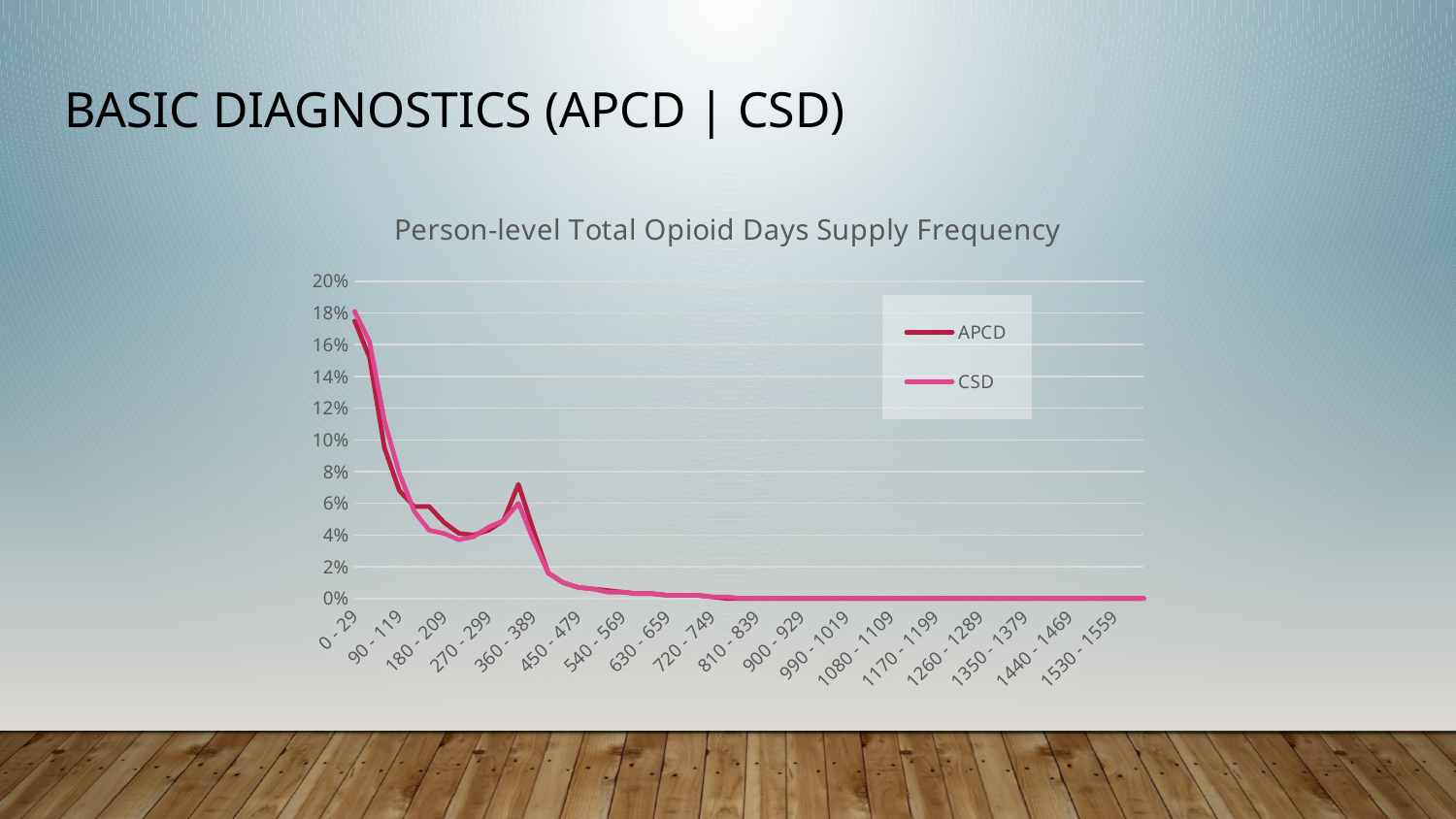
Do the values generally rise or fall moving from left to right along the x axis? fall Is the APCD value for the 540 - 569 category greater or less than 2%? less Is the APCD value for the 360 - 389 category greater or less than 8%? less At the 360 - 389 category, which series has the larger value, APCD or CSD? APCD For which category does the APCD series reach its highest value? 0 - 29 What is the title of the chart? Person-level Total Opioid Days Supply Frequency Which two series are listed in the chart legend? APCD and CSD Is the APCD value for the 0 - 29 category greater or less than 10%? greater How many series does the legend list? 2 What kind of chart is shown on the slide? line chart